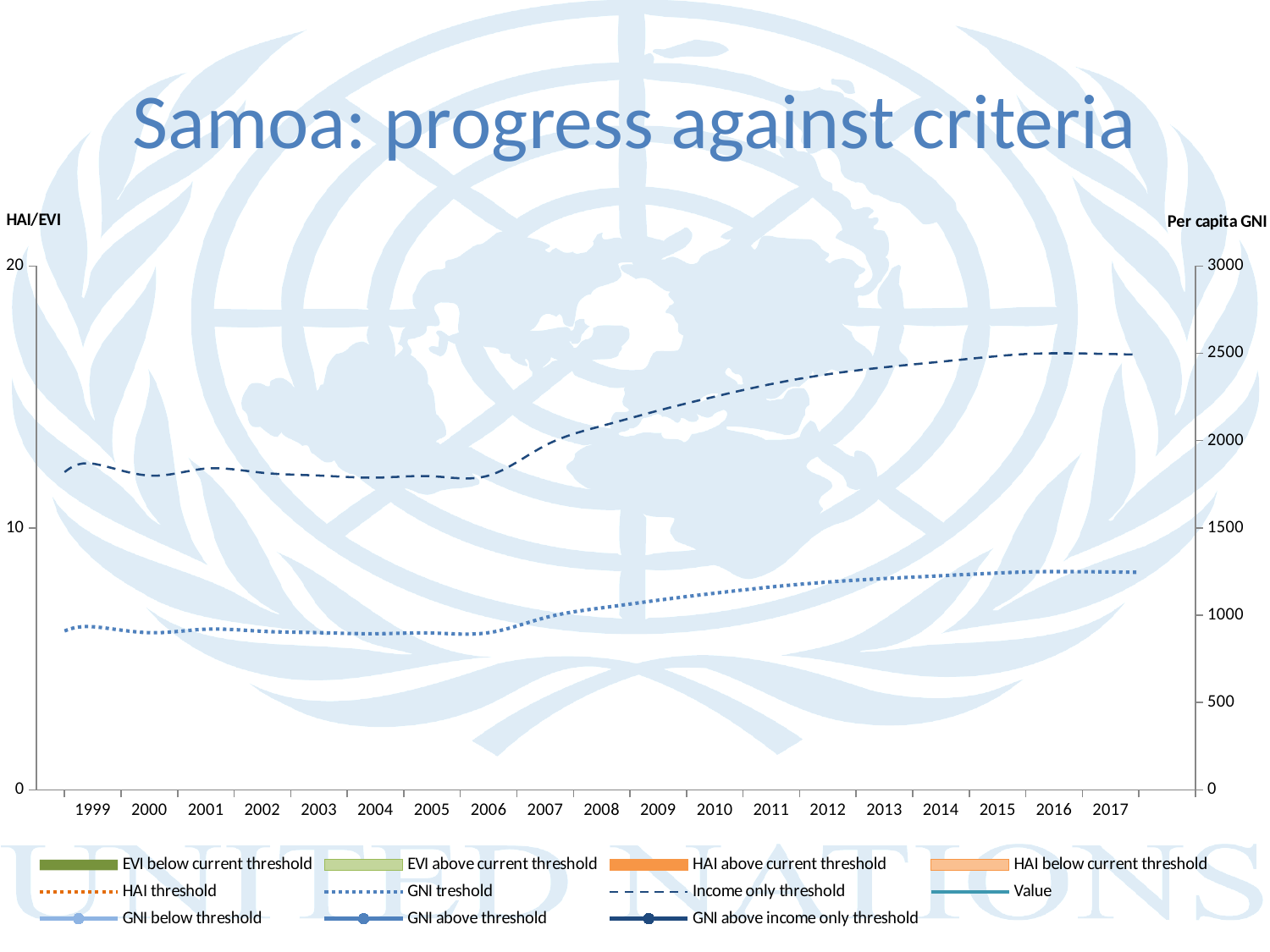
How many years are labelled along the x axis of the chart? 19 Is the Income only threshold value for 2006 greater or less than 1500 on the right axis? greater Is the GNI treshold value for 2017 greater or less than 1000 on the right axis? greater What is the label of the right-hand vertical axis? Per capita GNI Is the Income only threshold value for 2006 greater or less than 2000 on the right axis? less What is the title of the chart on the slide? Samoa: progress against criteria How many entries does the chart's legend list? 11 What kind of chart is shown on the slide? line chart Does the Income only threshold line rise or fall from 1999 to 2017? rise Does the GNI treshold line rise or fall from 2006 to 2017? rise In 2010, which line is higher: Income only threshold or GNI treshold? Income only threshold